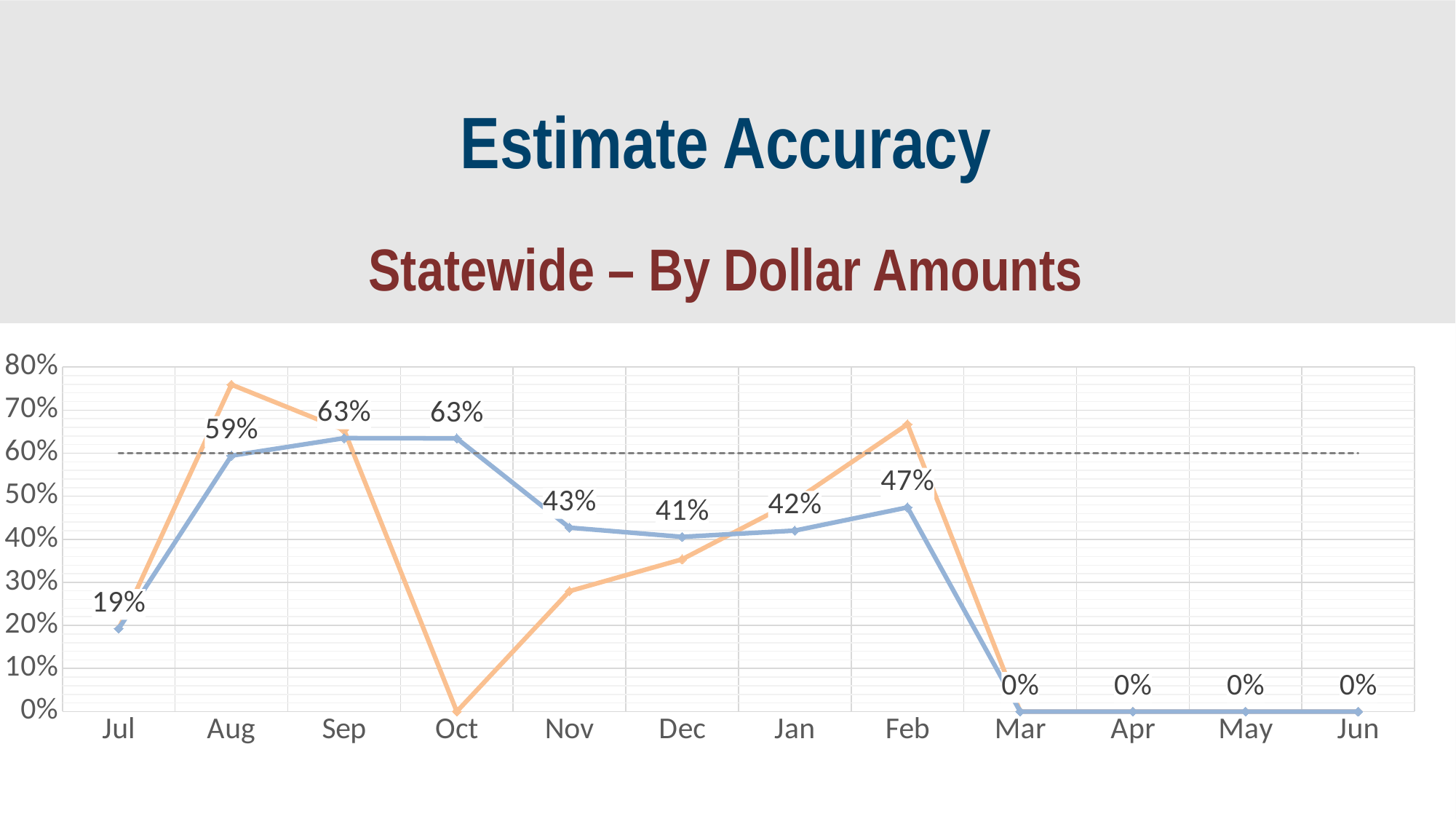
What is the labelled value of the blue line for Feb? 47% What is the labelled value of the blue line for Aug? 59% How many months show a labelled value of 0% on the blue line? 4 What is the labelled value of the blue line for Jul? 19% Does the blue line rise or fall from Feb to Mar? fall How many months are plotted along the x axis? 12 At what percentage is the horizontal dashed reference line drawn? 60% On the blue line, which month has the larger labelled value, Nov or Dec? Nov What kind of chart is shown on the slide? line chart What is the difference between the blue line's labelled values for Sep and Nov? 20 percentage points Is the value of the orange line for Oct greater or less than 10%? less Is the value of the orange line for Aug greater or less than 70%? greater